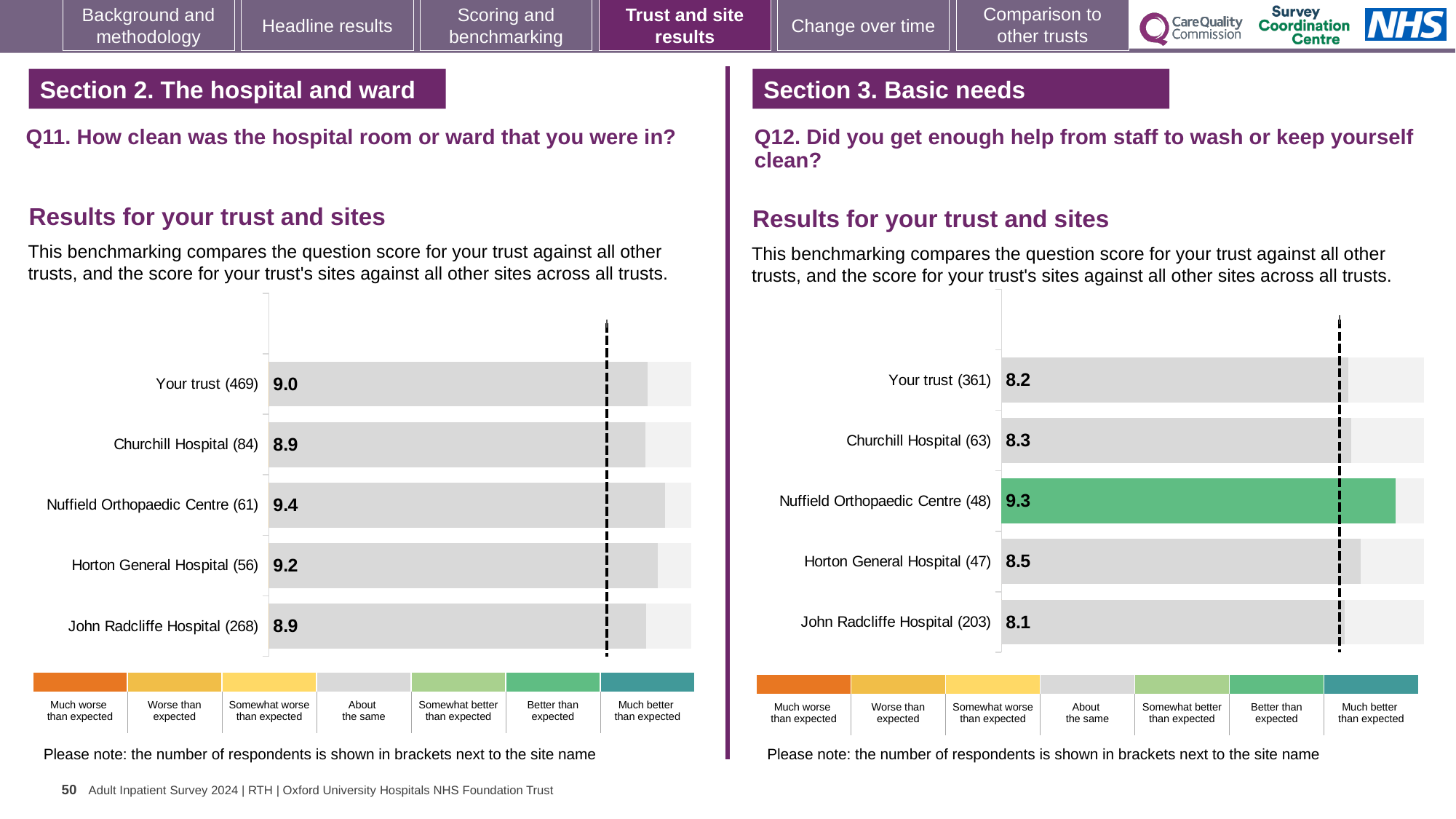
In the Q12 chart on the right, what is the score for Horton General Hospital? 8.5 In the Q12 chart on the right, which has the larger score, Churchill Hospital or Your trust? Churchill Hospital In the Q12 chart on the right, which site has the lowest score? John Radcliffe Hospital In the Q12 chart on the right, what is the difference between the scores for Nuffield Orthopaedic Centre and Your trust? 1.1 In the Q11 chart on the left, what is the score for Your trust? 9.0 In the Q11 chart on the left, what is the difference between the scores for Nuffield Orthopaedic Centre and John Radcliffe Hospital? 0.5 In the Q11 chart on the left, what is the score for Nuffield Orthopaedic Centre? 9.4 In the Q11 chart on the left, how many bars are plotted? 5 In the Q11 chart on the left, which site has the highest score? Nuffield Orthopaedic Centre In the Q12 chart on the right, which site has the highest score? Nuffield Orthopaedic Centre In the Q12 chart on the right, how many respondents are shown in brackets for John Radcliffe Hospital? 203 What type of chart is used for the Q12 results on the right? Bar chart